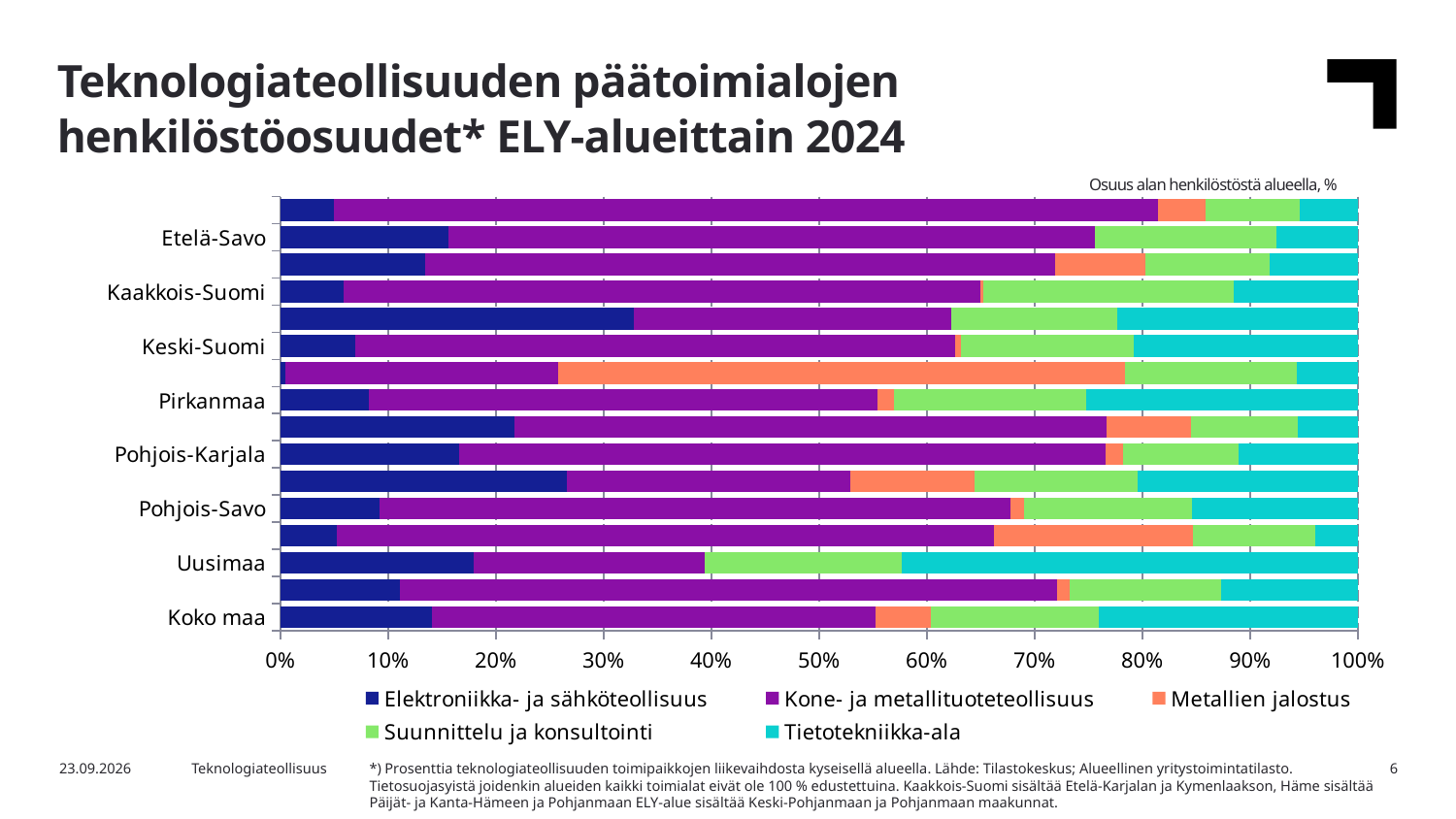
What is the maximum value shown on the horizontal axis? 100% Is the Kone- ja metallituoteteollisuus share for Uusimaa greater or less than 30%? less Is the Elektroniikka- ja sähköteollisuus share for Uusimaa greater or less than 10%? greater Is the Tietotekniikka-ala share for Pirkanmaa greater or less than 20%? greater What kind of chart is shown on the slide? Stacked bar chart Which has the larger Tietotekniikka-ala share, Uusimaa or Etelä-Savo? Uusimaa What is the title of the slide's chart? Teknologiateollisuuden päätoimialojen henkilöstöosuudet* ELY-alueittain 2024 How many series does the chart legend list? 5 Which has the larger Kone- ja metallituoteteollisuus share, Pohjois-Karjala or Uusimaa? Pohjois-Karjala